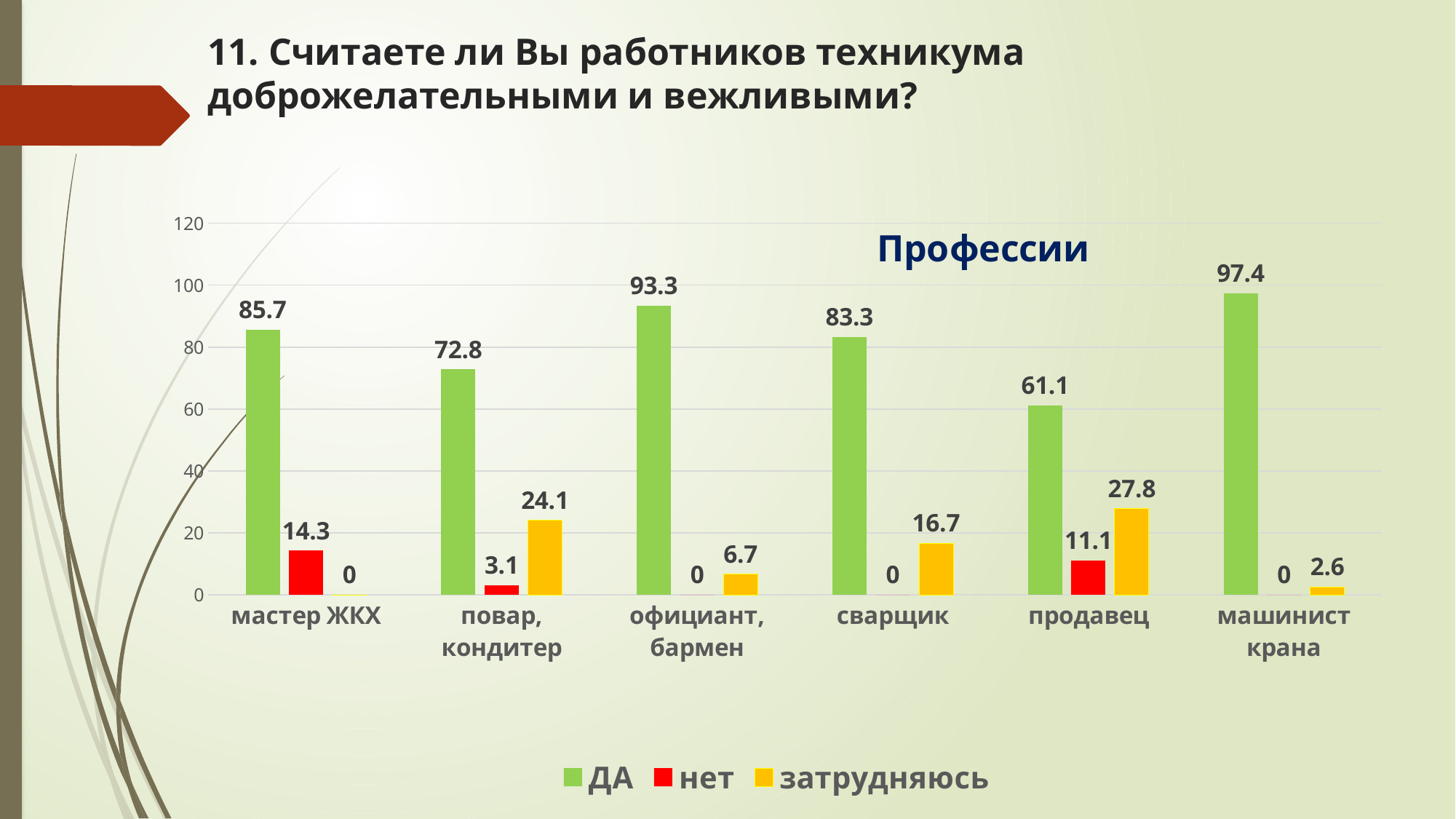
What is the value of the затрудняюсь series for продавец? 27.8 Which category has the lowest value in the ДА series? продавец Is the ДА value for сварщик greater or less than 80? greater Which is larger: the затрудняюсь value for сварщик or for официант, бармен? сварщик How many categories are shown on the x axis? 6 What kind of chart is shown on the slide? bar chart What colour represents the нет series in the chart? red What is the value of the нет series for мастер ЖКХ? 14.3 What is the difference between the ДА values for официант, бармен and повар, кондитер? 20.5 How many series does the legend list? 3 Which category has the highest value in the ДА series? машинист крана What is the value of the ДА series for машинист крана? 97.4